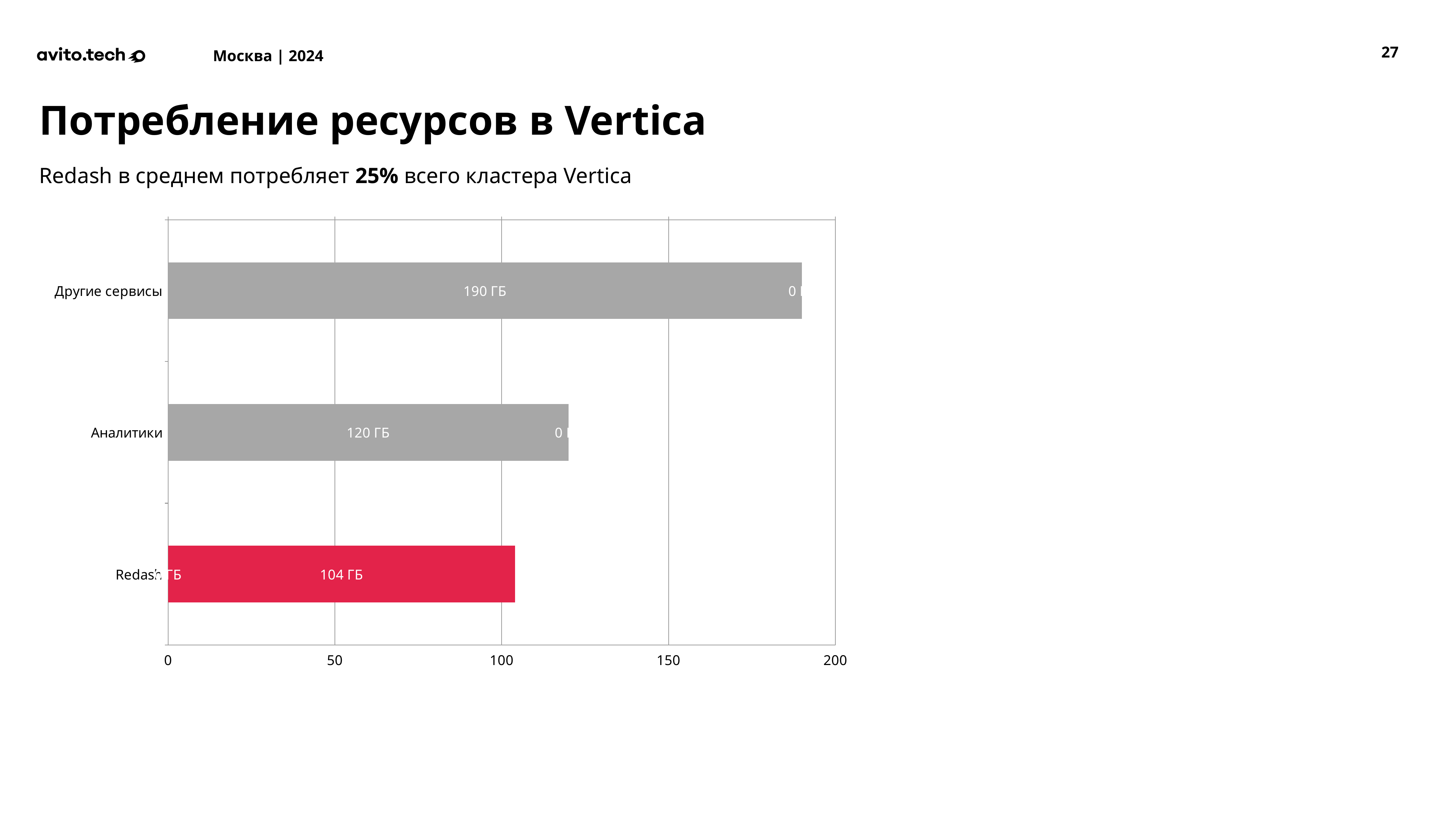
What is the value for Другие сервисы? 190 ГБ What is the difference between the values for Аналитики and Redash? 16 ГБ Which category's bar is coloured red? Redash Which is larger, the value for Аналитики or the value for Redash? Аналитики What is the value for Redash? 104 ГБ Is the value for Другие сервисы greater or less than 150? greater How many categories are shown in the chart? 3 What is the difference between the values for Другие сервисы and Redash? 86 ГБ Which category has the highest value? Другие сервисы What kind of chart is shown on the slide? bar chart Which category has the lowest value? Redash What is the value for Аналитики? 120 ГБ